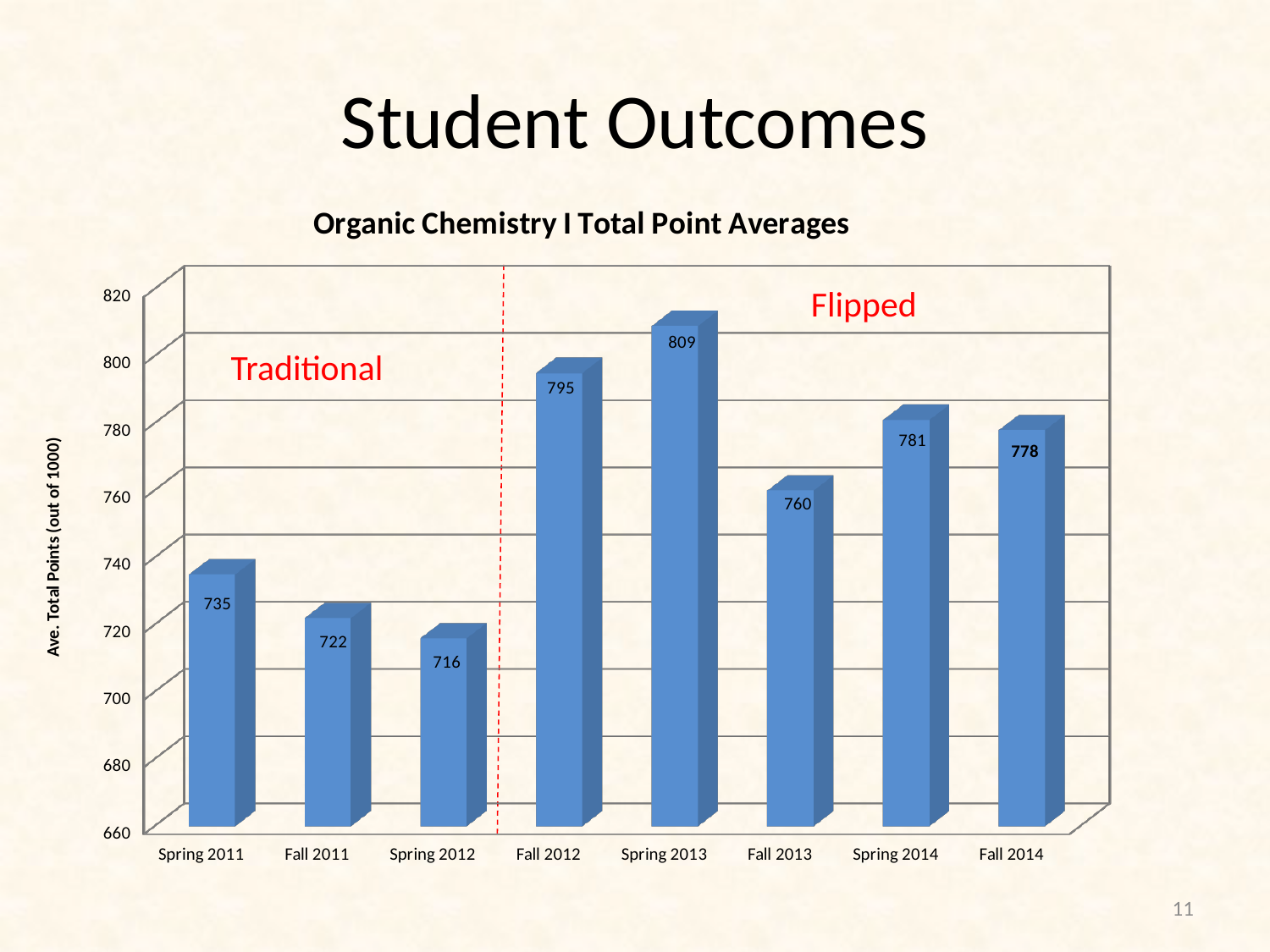
How many semesters are shown on the x axis? 8 What is the difference between the values for Spring 2013 and Spring 2012? 93 What is the difference between the values for Fall 2012 and Fall 2011? 73 What is the title of the chart? Organic Chemistry I Total Point Averages What is the value for Fall 2014? 778 Is the value for Fall 2013 greater or less than 740? greater Which semester has the highest total point average? Spring 2013 Which is larger, the value for Fall 2013 or the value for Spring 2014? Spring 2014 What is the value for Spring 2011? 735 What is the value for Spring 2012? 716 What kind of chart is this? bar chart Which semester has the lowest total point average? Spring 2012